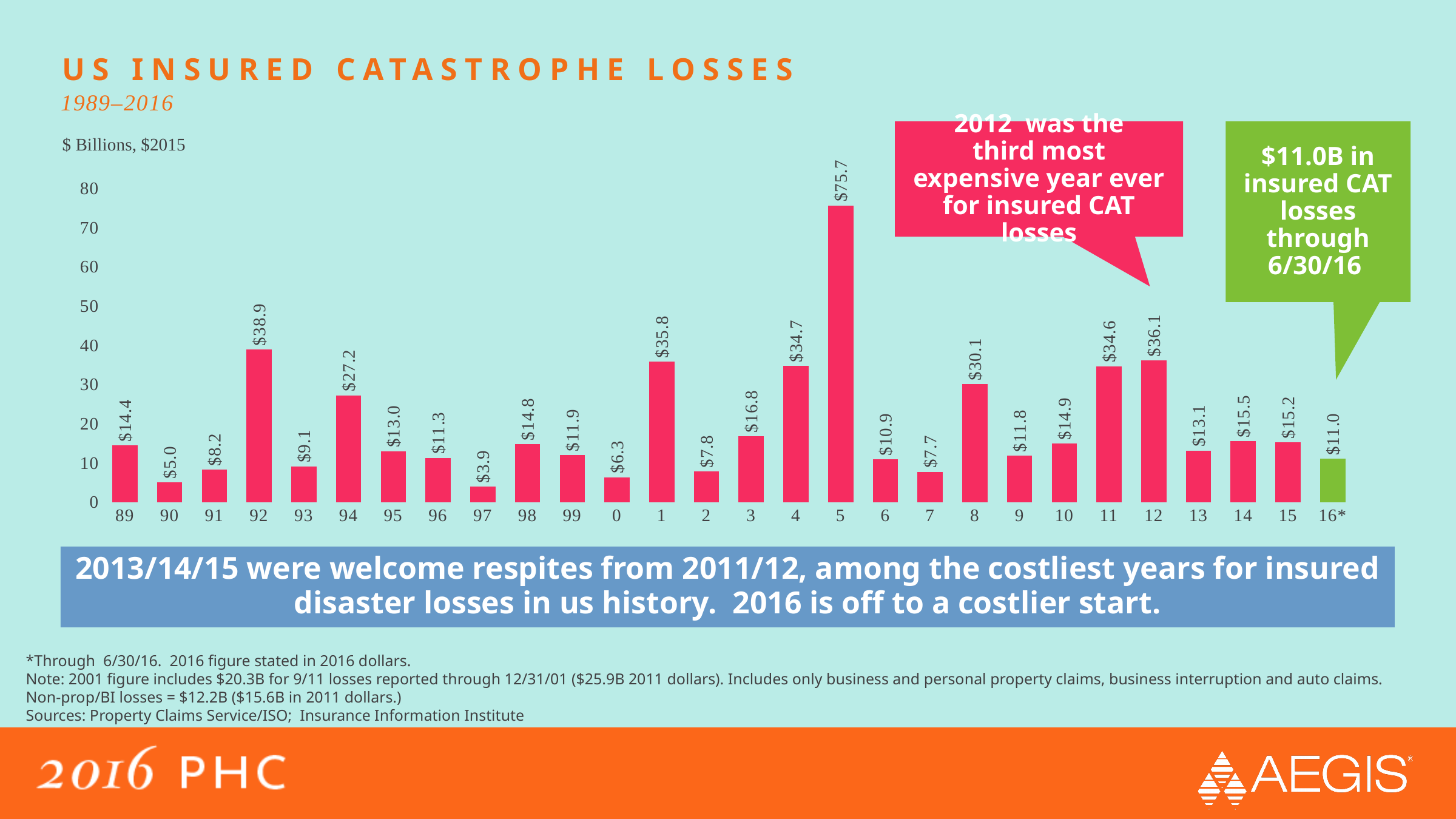
What is the value for 1992 (labelled 92) in the chart? $38.9 Which year has the lowest insured catastrophe losses in the chart? 97 (1997) What is the difference between the values for 5 and 12 in the chart? $39.6 What is the difference between the values for 92 and 94 in the chart? $11.7 What is the value for 2016 (labelled 16*) in the chart? $11.0 Is the value for 8 in the chart greater or less than 20? greater What kind of chart is shown on the slide? bar chart Which year has the highest insured catastrophe losses in the chart? 5 (2005) How many bars (years) are plotted in the chart? 28 Which is larger in the chart, the value for 92 or the value for 1? 92 Do the values rise or fall from 2 to 5 along the x axis? rise What is the value for 2005 (labelled 5) in the US Insured Catastrophe Losses chart? $75.7